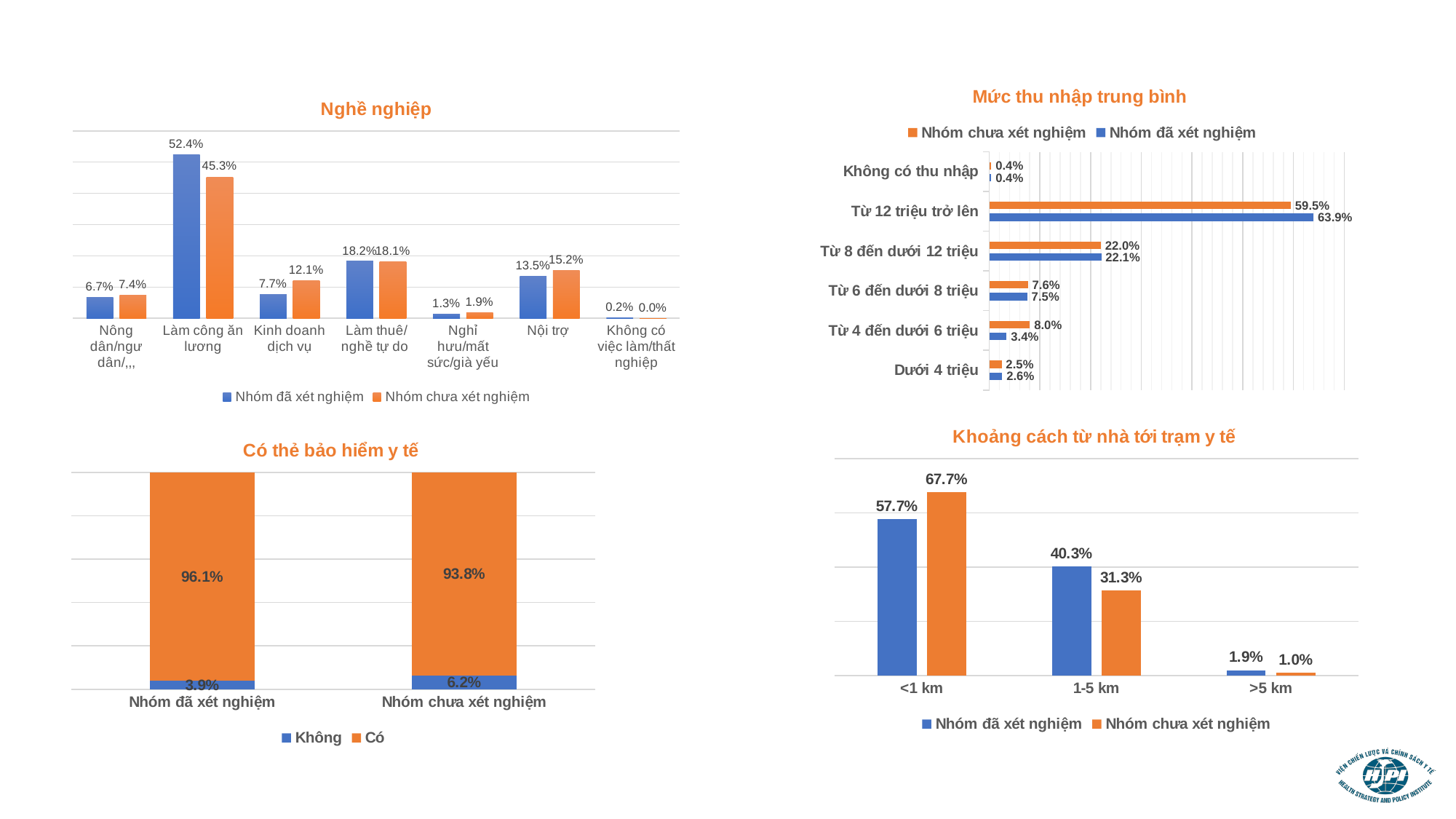
In the 'Có thẻ bảo hiểm y tế' chart, what is the total of the stacked bar for 'Nhóm đã xét nghiệm'? 100.0% In the 'Khoảng cách từ nhà tới trạm y tế' chart, do the 'Nhóm chưa xét nghiệm' values rise or fall from '<1 km' to '>5 km'? Fall In the 'Mức thu nhập trung bình' chart, what is the value for 'Từ 12 triệu trở lên' in the 'Nhóm đã xét nghiệm' series? 63.9% In the 'Nghề nghiệp' chart, which category has the highest value for 'Nhóm chưa xét nghiệm'? Làm công ăn lương In the 'Có thẻ bảo hiểm y tế' chart, what is the 'Có' value for 'Nhóm chưa xét nghiệm'? 93.8% In the 'Khoảng cách từ nhà tới trạm y tế' chart, what is the value for '1-5 km' in the 'Nhóm đã xét nghiệm' series? 40.3% In the 'Mức thu nhập trung bình' chart, how many income categories are listed? 6 In the 'Mức thu nhập trung bình' chart, which is larger for 'Từ 4 đến dưới 6 triệu': 'Nhóm chưa xét nghiệm' or 'Nhóm đã xét nghiệm'? Nhóm chưa xét nghiệm In the 'Nghề nghiệp' chart, what is the difference between the 'Nhóm đã xét nghiệm' and 'Nhóm chưa xét nghiệm' values for 'Kinh doanh dịch vụ'? 4.4% In the 'Nghề nghiệp' chart, what is the value for 'Làm công ăn lương' in the 'Nhóm đã xét nghiệm' series? 52.4% In the 'Nghề nghiệp' chart, how many occupation categories are shown on the x axis? 7 What kind of chart is 'Mức thu nhập trung bình'? Bar chart